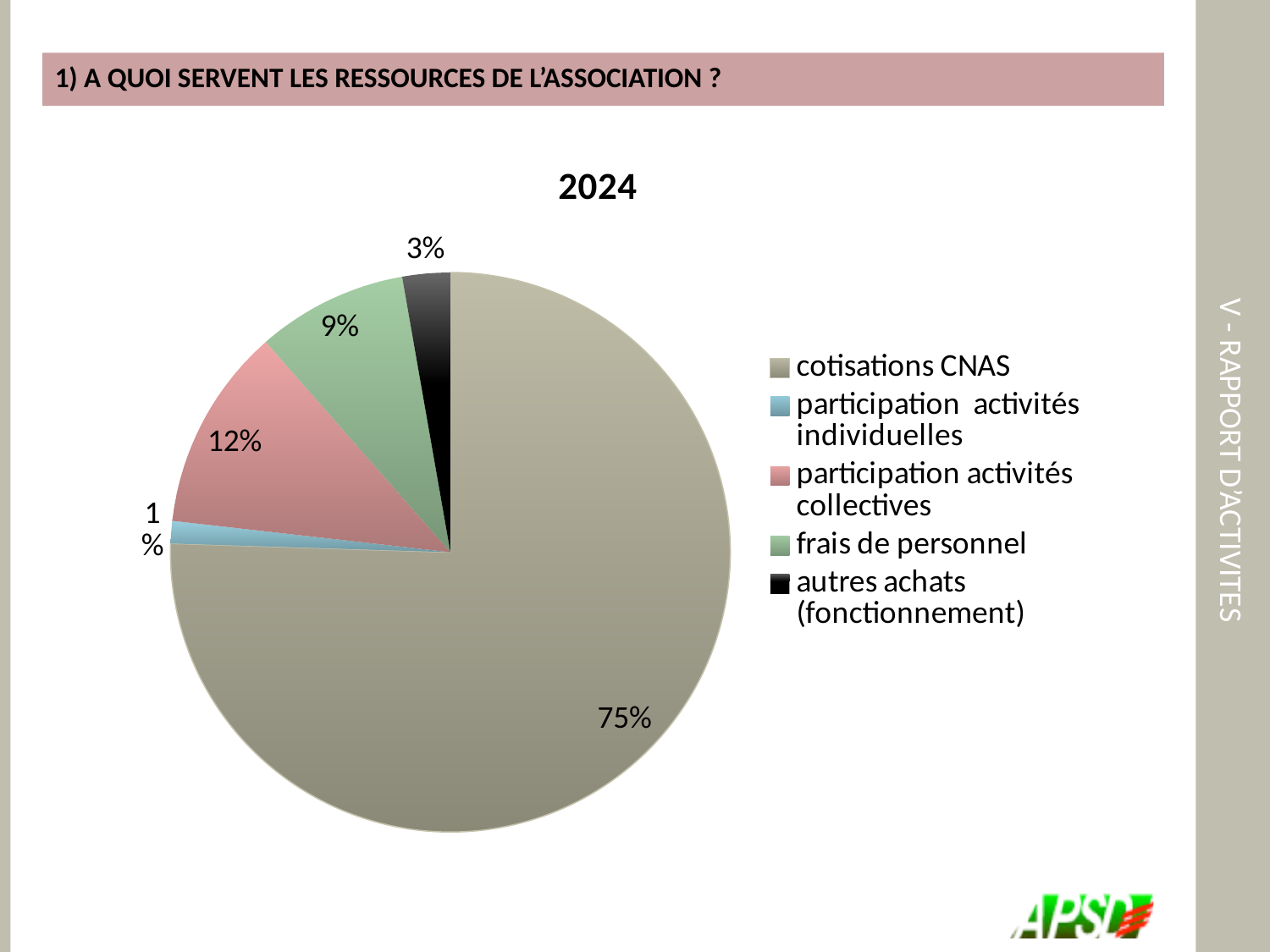
What is the chart's title? 2024 What share of the pie is autres achats (fonctionnement)? 3% Which is larger, the share for frais de personnel or the share for autres achats (fonctionnement)? frais de personnel What share of the pie is participation activités individuelles? 1% What type of chart is shown on the slide? pie chart What share of the pie is participation activités collectives? 12% What is the difference between the shares of participation activités collectives and frais de personnel? 3% Which category has the largest slice of the pie? cotisations CNAS Which category has the smallest slice of the pie? participation activités individuelles How many categories does the pie chart have? 5